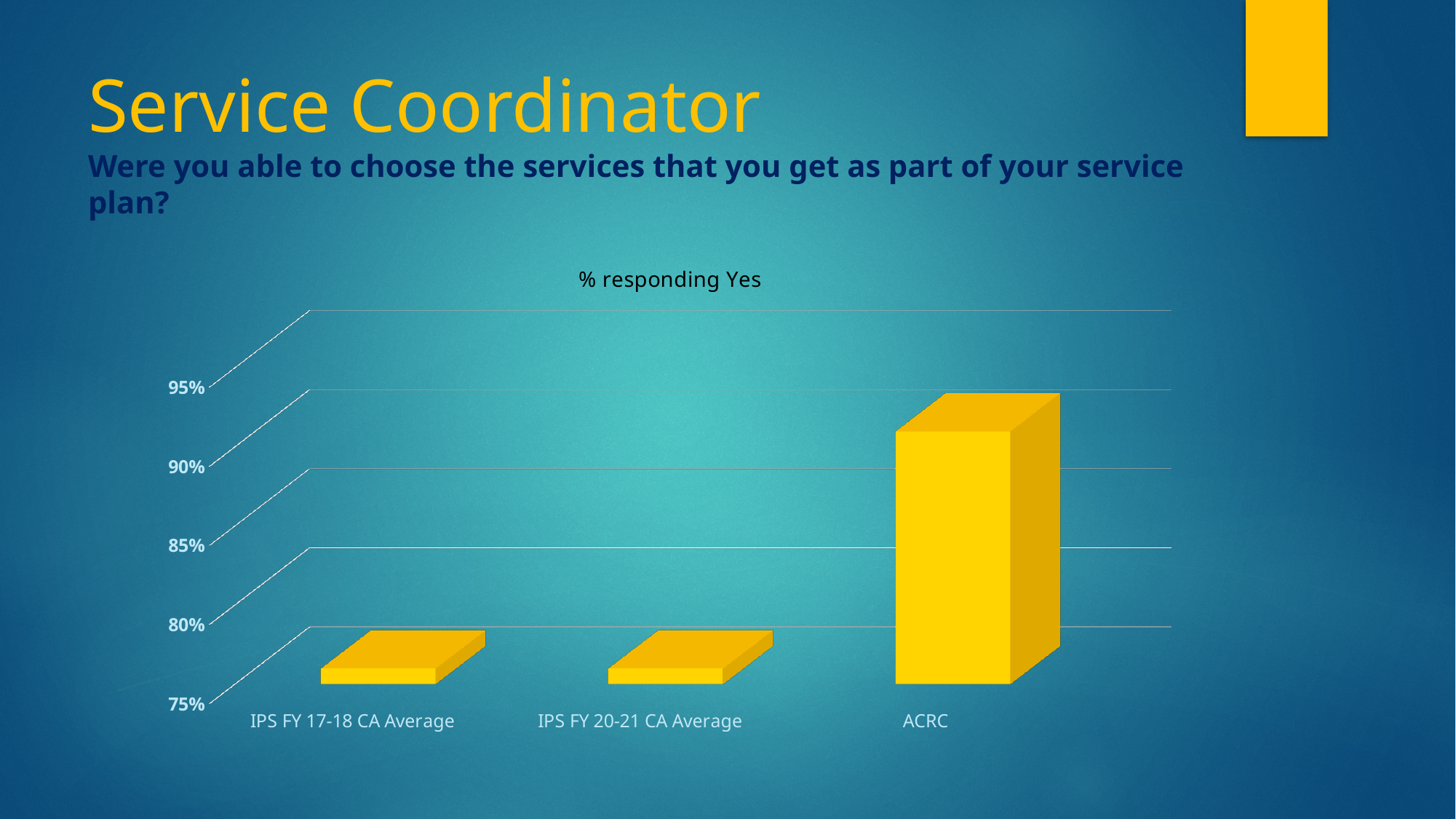
What is the title of the chart? % responding Yes Which category has the highest value in the chart? ACRC Which is larger, the value for IPS FY 17-18 CA Average or the value for ACRC? ACRC What is the lowest value shown on the chart's vertical axis? 75% Is the value for IPS FY 17-18 CA Average greater or less than 80%? less How many categories are plotted in the chart? 3 What kind of chart is shown on the slide? bar chart Is the value for ACRC greater or less than 90%? greater Is the value for ACRC greater or less than 95%? less Which is larger, the value for ACRC or the value for IPS FY 20-21 CA Average? ACRC